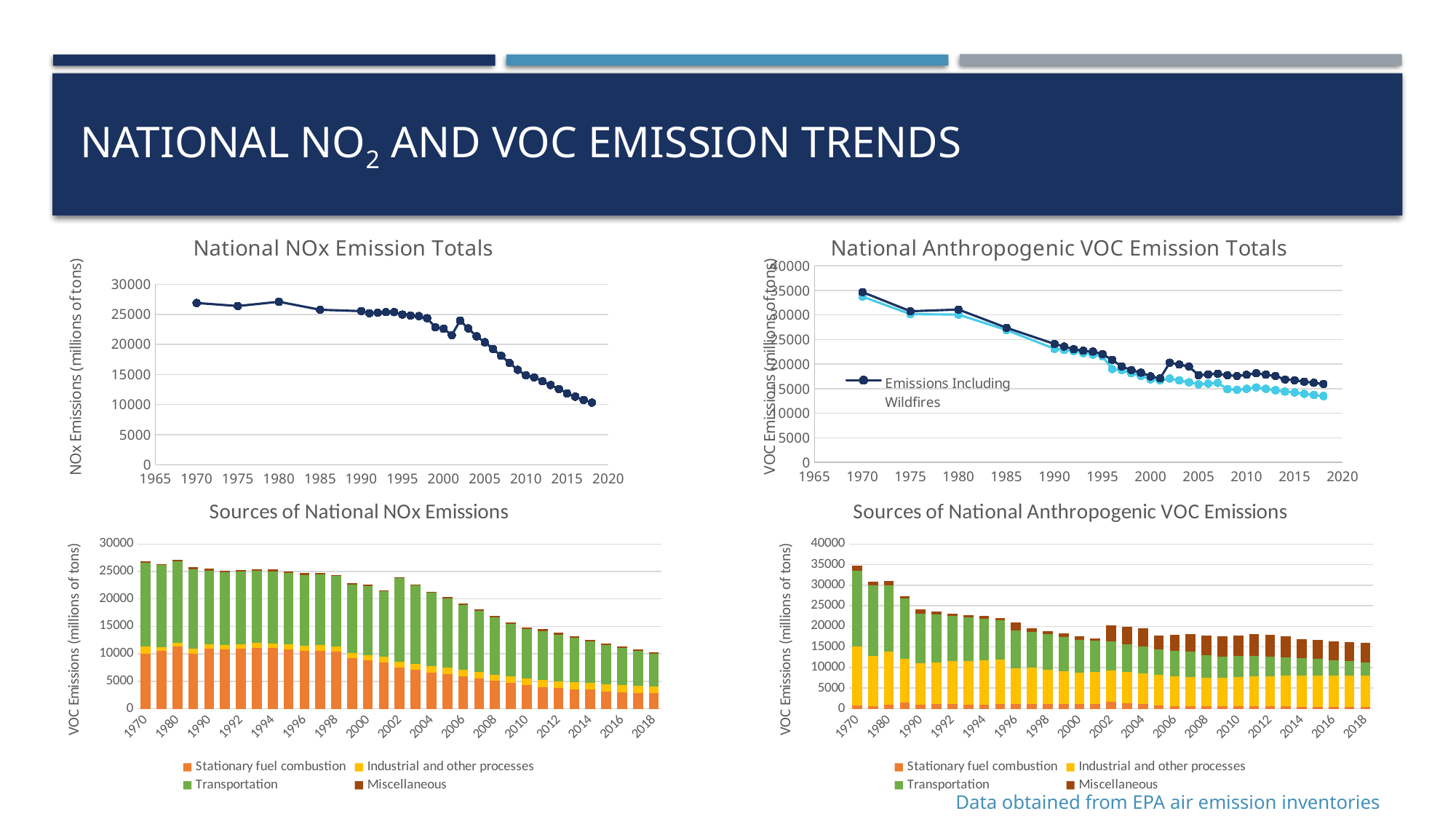
In the 'National NOx Emission Totals' chart, do the values rise or fall from 1970 to 2018? fall What kind of chart is the 'National NOx Emission Totals' chart? line chart How many series does the legend of the 'Sources of National NOx Emissions' chart list? 4 In the 'National NOx Emission Totals' chart, is the value for 2018 greater or less than 15000? less In the 'National Anthropogenic VOC Emission Totals' chart, what is the legend entry shown? Emissions Including Wildfires In the 'National Anthropogenic VOC Emission Totals' chart, is the value for 1970 greater or less than 30000? greater In the 'Sources of National NOx Emissions' chart, which is larger in 1970: Transportation or Stationary fuel combustion? Transportation In the 'Sources of National Anthropogenic VOC Emissions' chart, which is larger in 2018: Industrial and other processes or Transportation? Industrial and other processes What kind of chart is the 'Sources of National NOx Emissions' chart? bar chart In the 'Sources of National NOx Emissions' chart, is the total stacked bar for 2018 greater or less than 15000? less In the 'Sources of National Anthropogenic VOC Emissions' chart, do the total bar heights rise or fall from 1970 to 2018? fall